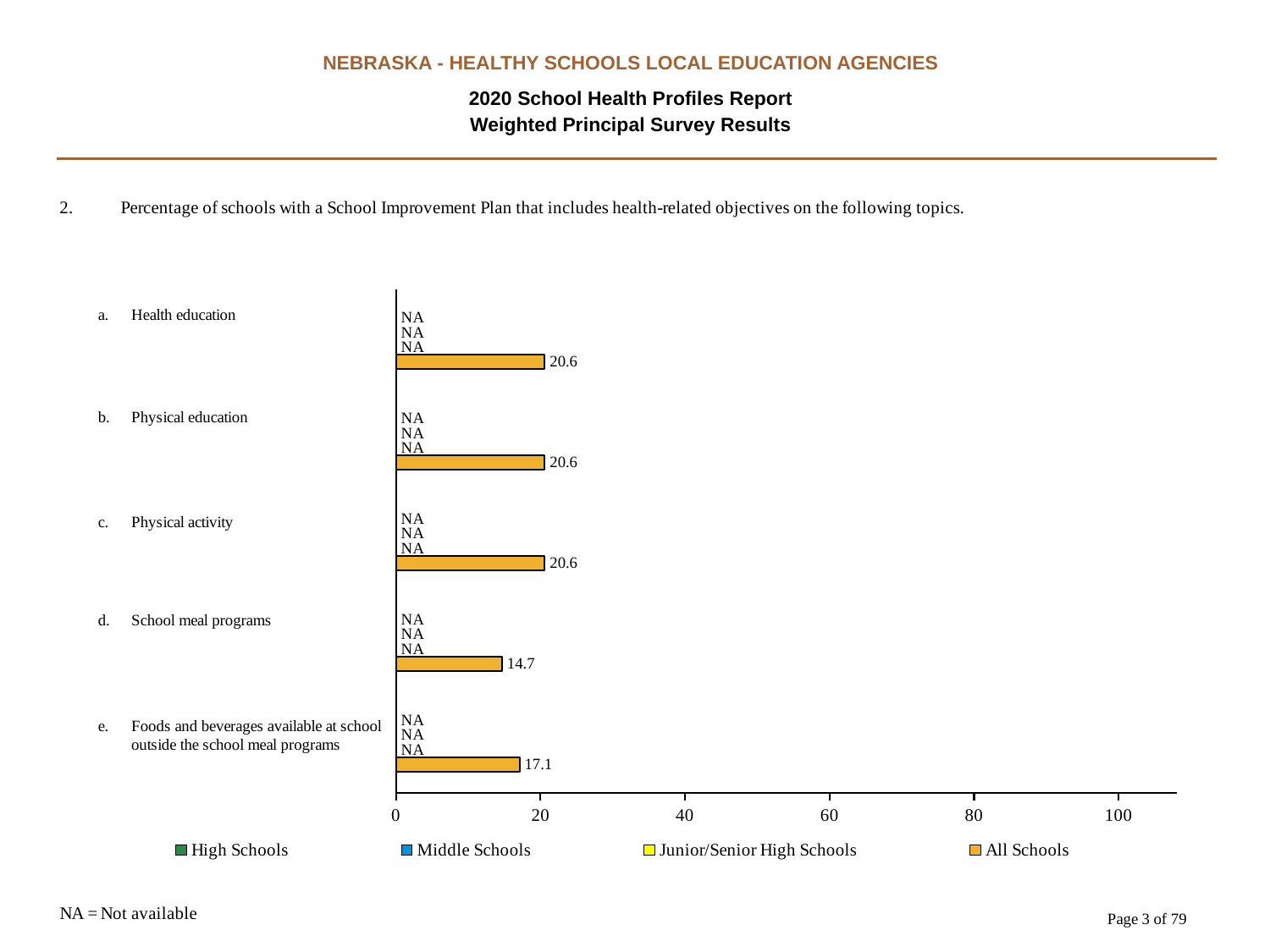
What is the difference between the All Schools values for Physical education and School meal programs? 5.9 What is the All Schools value for Physical activity? 20.6 What kind of chart is shown? bar chart What value is shown for High Schools for Physical education? NA What is the All Schools value for School meal programs? 14.7 What is the All Schools value for Health education? 20.6 Which topic has the lowest All Schools value? School meal programs How many series does the legend list? 4 How many topics are listed on the chart? 5 Is the All Schools value for Health education greater or less than 40? less Which is larger for All Schools: School meal programs or Foods and beverages available at school outside the school meal programs? Foods and beverages available at school outside the school meal programs What is the All Schools value for Foods and beverages available at school outside the school meal programs? 17.1